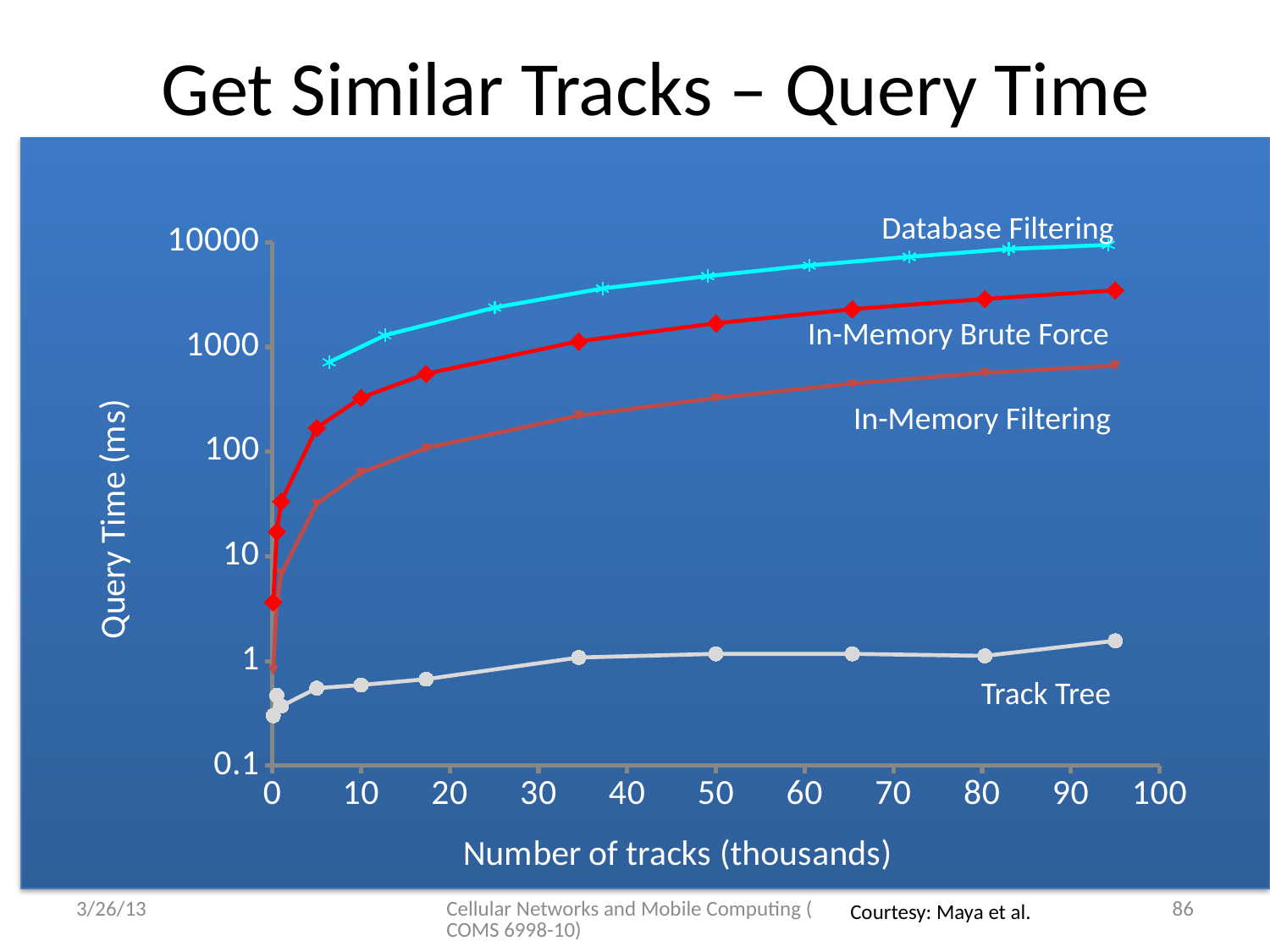
Which series has the highest query time across the range of track counts? Database Filtering How many data series are plotted on the chart? 4 Is the query time for Track Tree at 10 thousand tracks greater or less than 1 ms? less Does the query time for Database Filtering rise or fall as the number of tracks increases? rise What is the label of the y axis? Query Time (ms) What kind of chart is shown on the slide? line chart At 50 thousand tracks, which has the larger query time: In-Memory Brute Force or In-Memory Filtering? In-Memory Brute Force At 50 thousand tracks, which has the larger query time: Database Filtering or Track Tree? Database Filtering Which series has the lowest query time across the range of track counts? Track Tree What is the label of the x axis? Number of tracks (thousands) Is the query time for In-Memory Filtering at 50 thousand tracks greater or less than 1000 ms? less